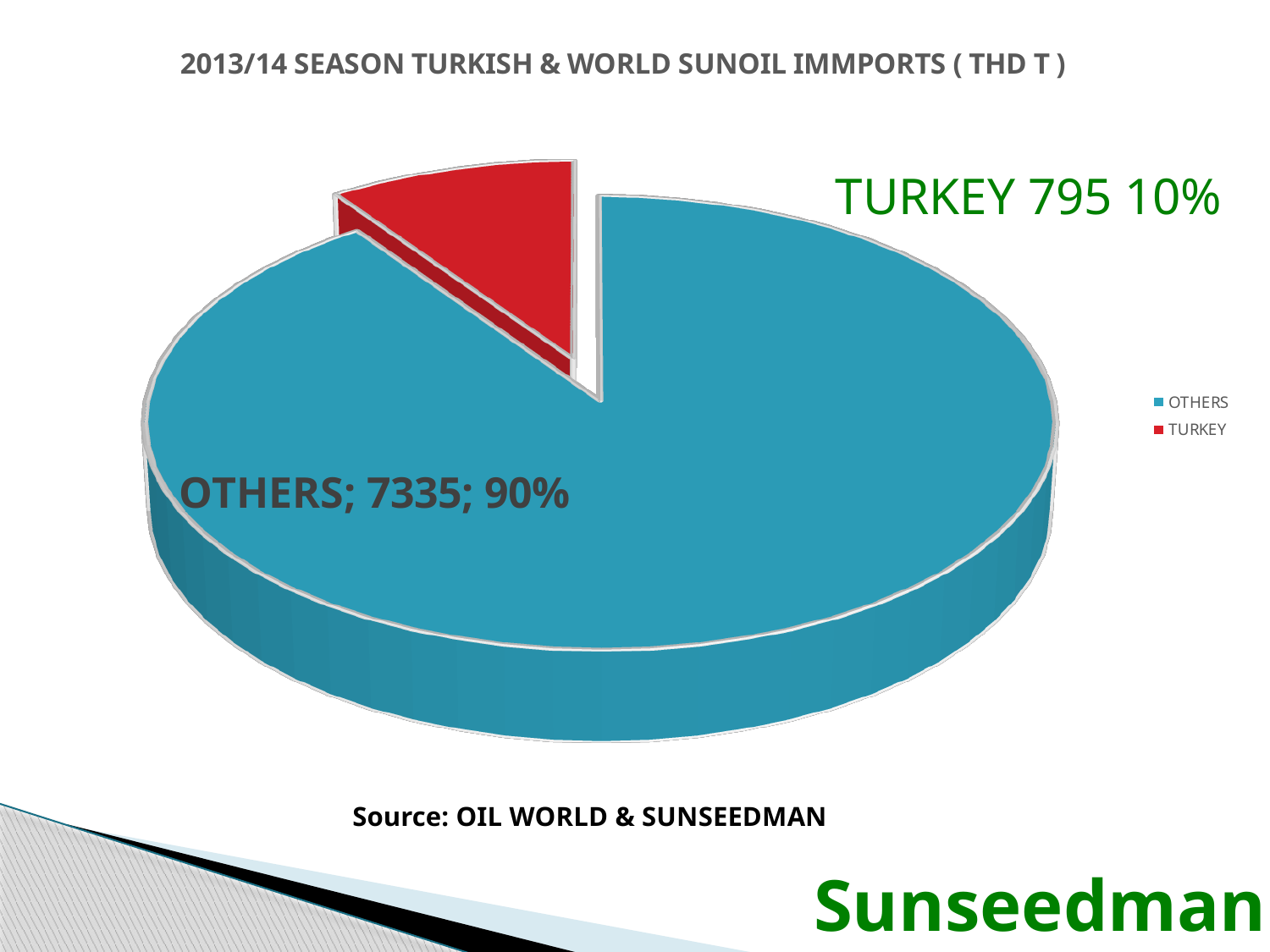
What is the value for TURKEY? 795 What share of the pie does TURKEY represent? 10% What share of the pie does OTHERS represent? 90% What is the total of the two values shown in the pie chart? 8130 What colour is the TURKEY slice? Red Which category has the smallest slice of the pie? TURKEY Which is larger, the value for OTHERS or the value for TURKEY? OTHERS What is the value for OTHERS? 7335 How many categories are shown in the pie chart? 2 What kind of chart is shown on the slide? Pie chart What is the difference between the values for OTHERS and TURKEY? 6540 Which category has the largest slice of the pie? OTHERS